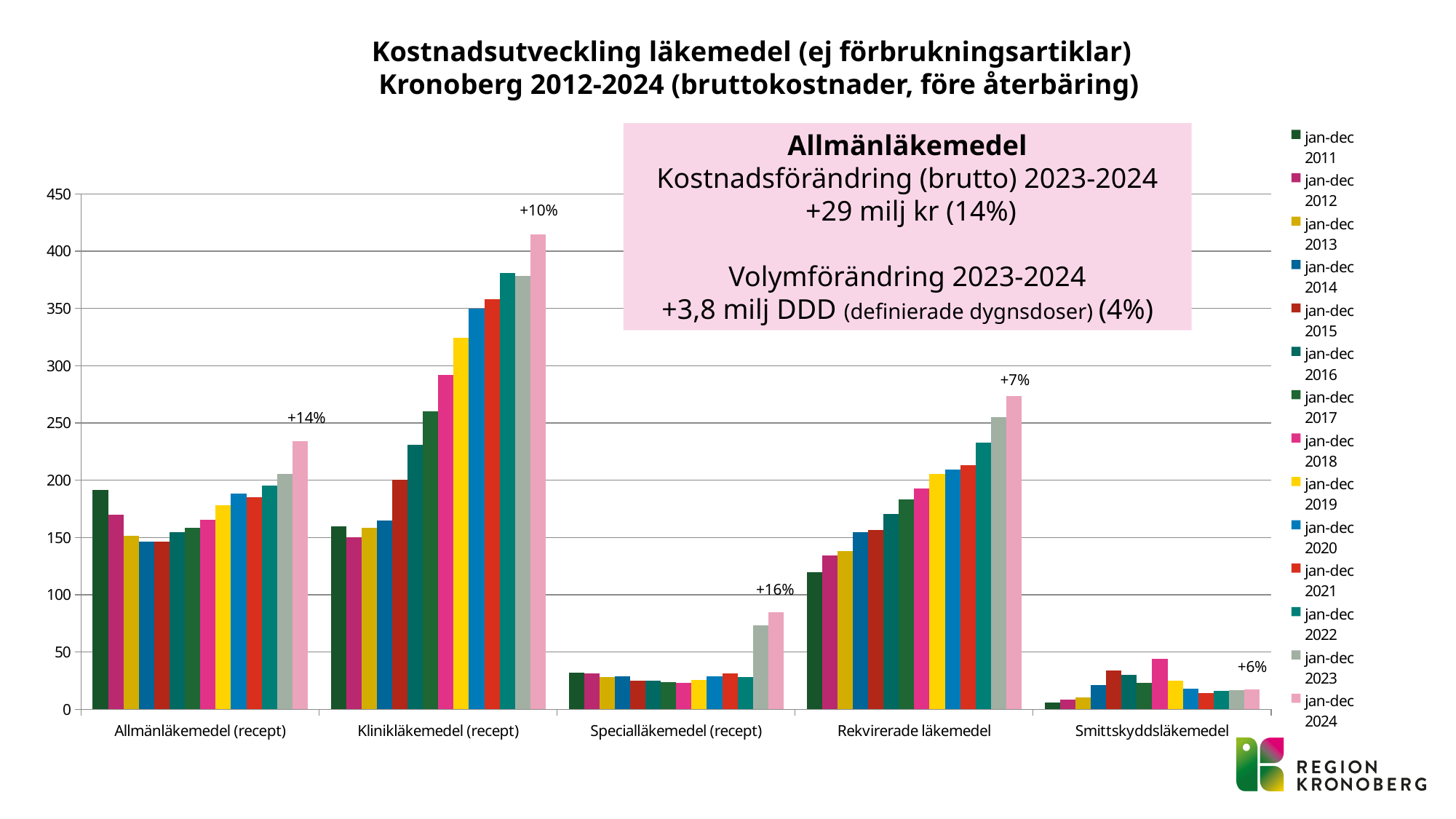
Is the jan-dec 2024 value for Rekvirerade läkemedel greater or less than 250? greater Which category has the tallest bar in the chart? Klinikläkemedel (recept) Which category has the lowest bars overall? Smittskyddsläkemedel Which is larger for jan-dec 2024: Klinikläkemedel (recept) or Rekvirerade läkemedel? Klinikläkemedel (recept) Is the jan-dec 2024 value for Klinikläkemedel (recept) greater or less than 400? greater How many series does the legend list? 14 Is the jan-dec 2024 value for Specialläkemedel (recept) greater or less than 100? less Do the values for Rekvirerade läkemedel rise or fall from jan-dec 2011 to jan-dec 2024? rise What percentage change is annotated above the Allmänläkemedel (recept) bars? +14% How many categories are shown on the x axis? 5 What percentage change is annotated above the Specialläkemedel (recept) bars? +16% What kind of chart is shown on the slide? bar chart